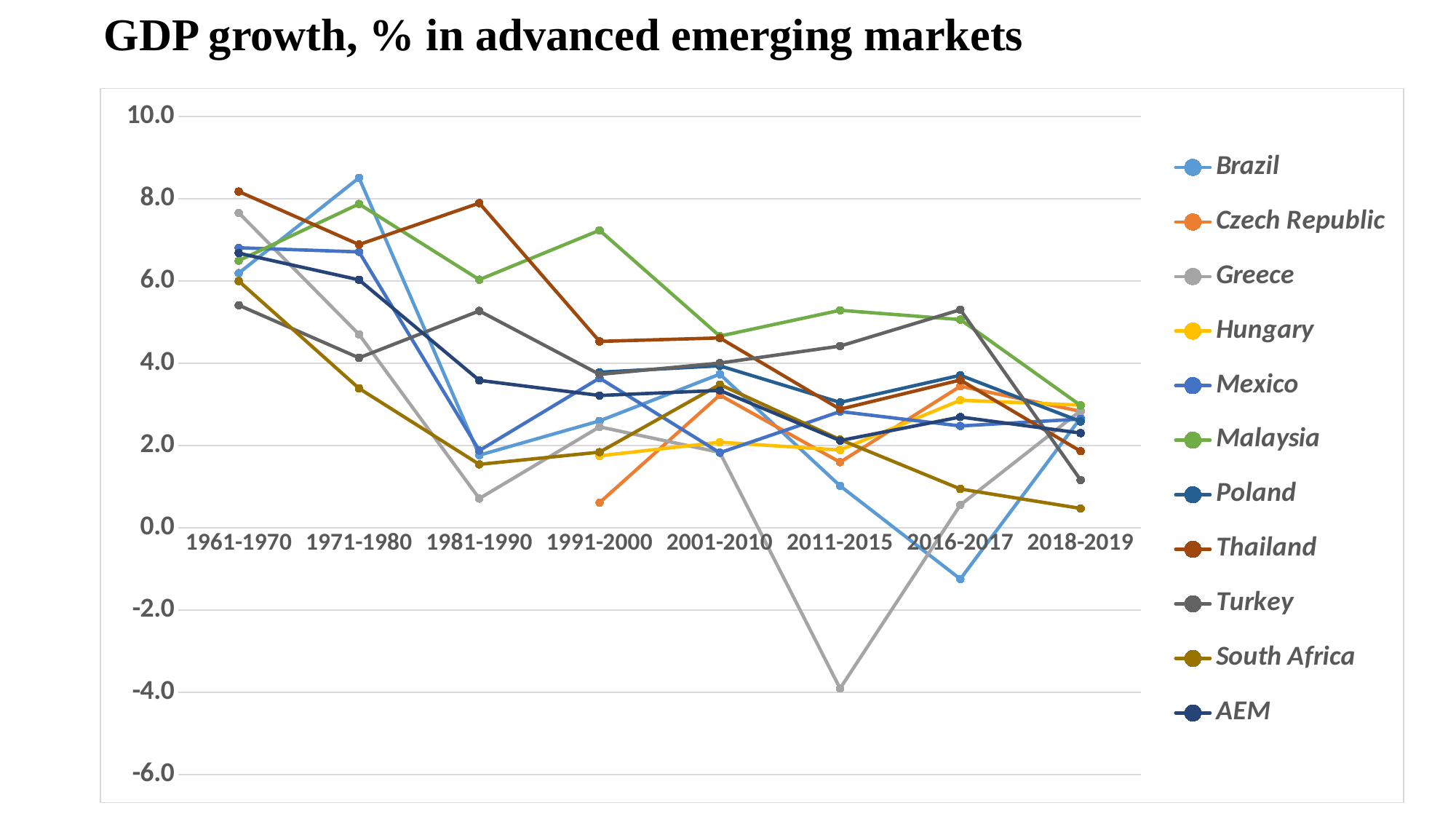
How many time periods are shown along the x axis? 8 Which series has the highest value in the 1991-2000 period? Malaysia What is the title of the chart? GDP growth, % in advanced emerging markets Is the value for Greece in 2011-2015 greater or less than -2.0? less Does the Thailand series rise or fall overall from 1961-1970 to 2018-2019? Fall In 1961-1970, which is larger: the value for Thailand or the value for Brazil? Thailand Which series has the lowest value in the 2016-2017 period? Brazil Is the value for Thailand in 1961-1970 greater or less than 8.0? greater Which series has the lowest value in the 2011-2015 period? Greece Which series has the highest value in the 1971-1980 period? Brazil How many series does the legend list? 11 What kind of chart is shown on the slide? Line chart